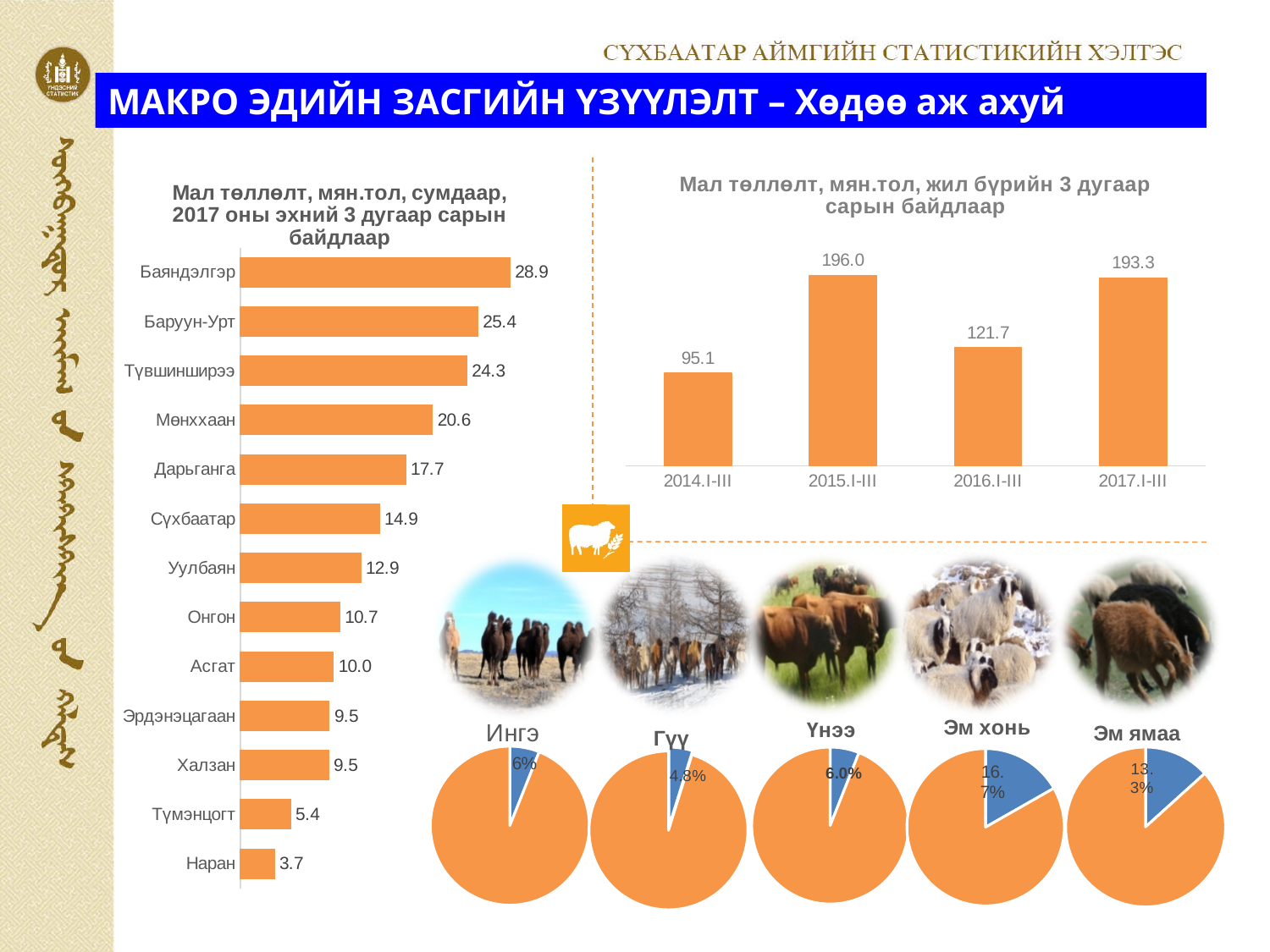
In the right chart (Мал төллөлт, мян.тол, жил бүрийн 3 дугаар сарын байдлаар), what is the difference between 2015.I-III and 2014.I-III? 100.9 In the left chart (Мал төллөлт, мян.тол, сумдаар), what is the value for Баяндэлгэр? 28.9 What kind of chart is the left chart (Мал төллөлт, мян.тол, сумдаар)? Bar chart In the left chart (Мал төллөлт, мян.тол, сумдаар), which sum has the highest value? Баяндэлгэр How many sums are shown in the left chart (Мал төллөлт, мян.тол, сумдаар)? 13 In the left chart (Мал төллөлт, мян.тол, сумдаар), what is the difference between Баруун-Урт and Түвшинширээ? 1.1 In the right chart (Мал төллөлт, мян.тол, жил бүрийн 3 дугаар сарын байдлаар), what is the value for 2016.I-III? 121.7 In the right chart (Мал төллөлт, мян.тол, жил бүрийн 3 дугаар сарын байдлаар), which is larger: 2016.I-III or 2017.I-III? 2017.I-III In the right chart (Мал төллөлт, мян.тол, жил бүрийн 3 дугаар сарын байдлаар), which period has the highest value? 2015.I-III In the left chart (Мал төллөлт, мян.тол, сумдаар), which sum has the lowest value? Наран In the pie chart labelled Эм хонь, what share does the blue slice represent? 16.7% How many periods are shown in the right chart (Мал төллөлт, мян.тол, жил бүрийн 3 дугаар сарын байдлаар)? 4